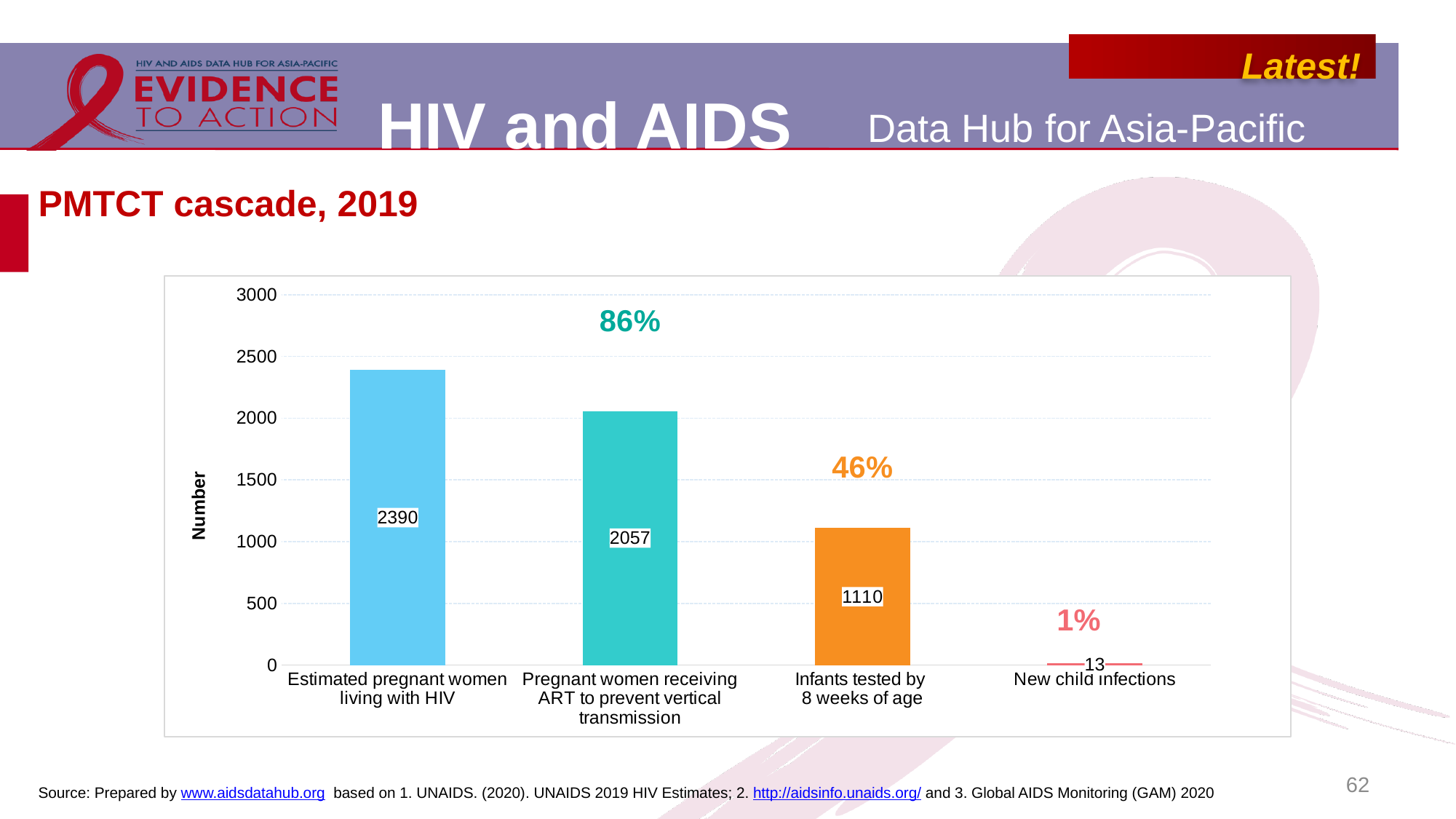
What percentage is printed above the Infants tested by 8 weeks of age bar? 46% Which is larger: Pregnant women receiving ART to prevent vertical transmission or Infants tested by 8 weeks of age? Pregnant women receiving ART to prevent vertical transmission What is the value for New child infections? 13 Which category has the highest value? Estimated pregnant women living with HIV Is the value for Infants tested by 8 weeks of age greater or less than 1500? less What kind of chart is shown on the slide? bar chart What is the difference between Estimated pregnant women living with HIV and Pregnant women receiving ART to prevent vertical transmission? 333 What is the value for Estimated pregnant women living with HIV? 2390 How many categories are shown on the x axis? 4 What is the value for Infants tested by 8 weeks of age? 1110 Which category has the lowest value? New child infections What is the value for Pregnant women receiving ART to prevent vertical transmission? 2057